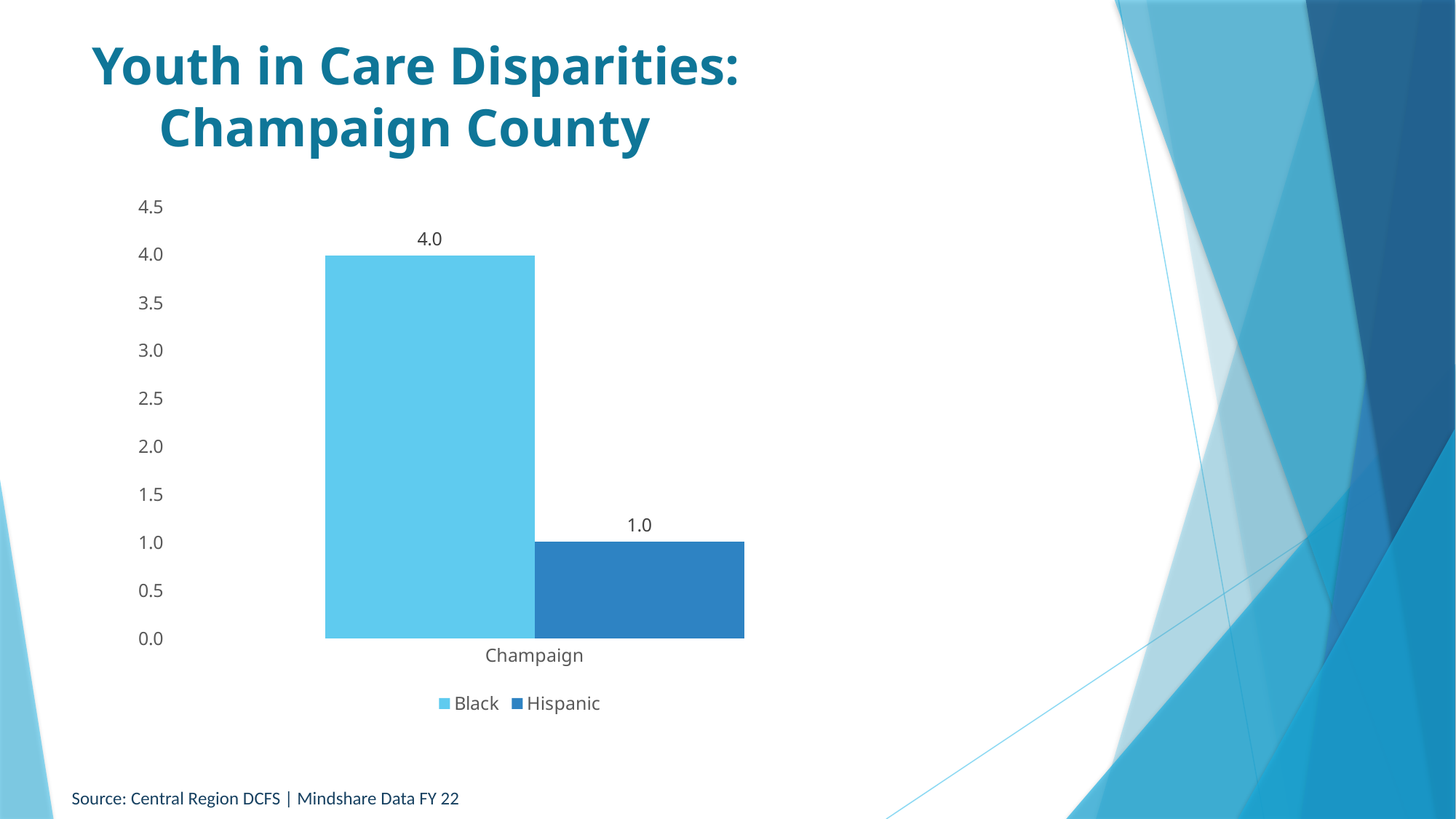
What kind of chart is shown on the slide? Bar chart What is the difference between the Black and Hispanic values for Champaign? 3.0 What is the title of the slide? Youth in Care Disparities: Champaign County What is the highest value shown on the y axis? 4.5 Is the value for Hispanic in Champaign greater or less than 2.0? less Which series has the higher value for Champaign, Black or Hispanic? Black What is the value for Black in Champaign? 4.0 Which series has the lowest value in the chart? Hispanic What is the value for Hispanic in Champaign? 1.0 Is the value for Black in Champaign greater or less than 3.5? greater How many series does the legend list? 2 How many categories are shown on the x axis? 1